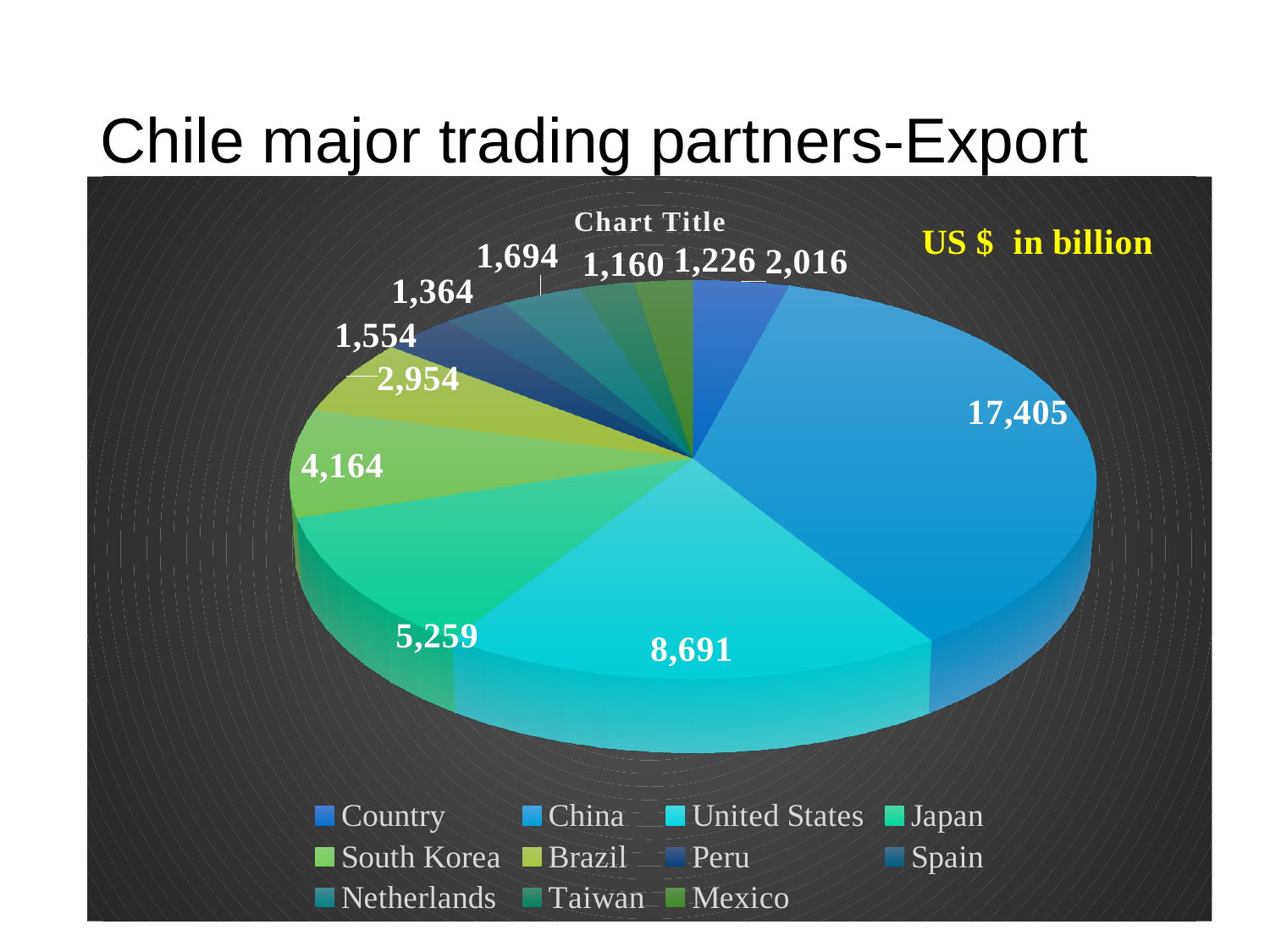
How many entries does the legend list? 11 What is the difference between the export values for Japan and South Korea? 1,095 What is the export value for China? 17,405 What is the export value for Japan? 5,259 What is the export value for the United States? 8,691 What kind of chart is shown on the slide? Pie chart What unit is stated for the values in the chart? US $ in billion Which is larger, the export value for Japan or for South Korea? Japan What is the export value for South Korea? 4,164 Which trading partner has the largest export value? China What is the difference between the export values for China and the United States? 8,714 What is the export value for Brazil? 2,954